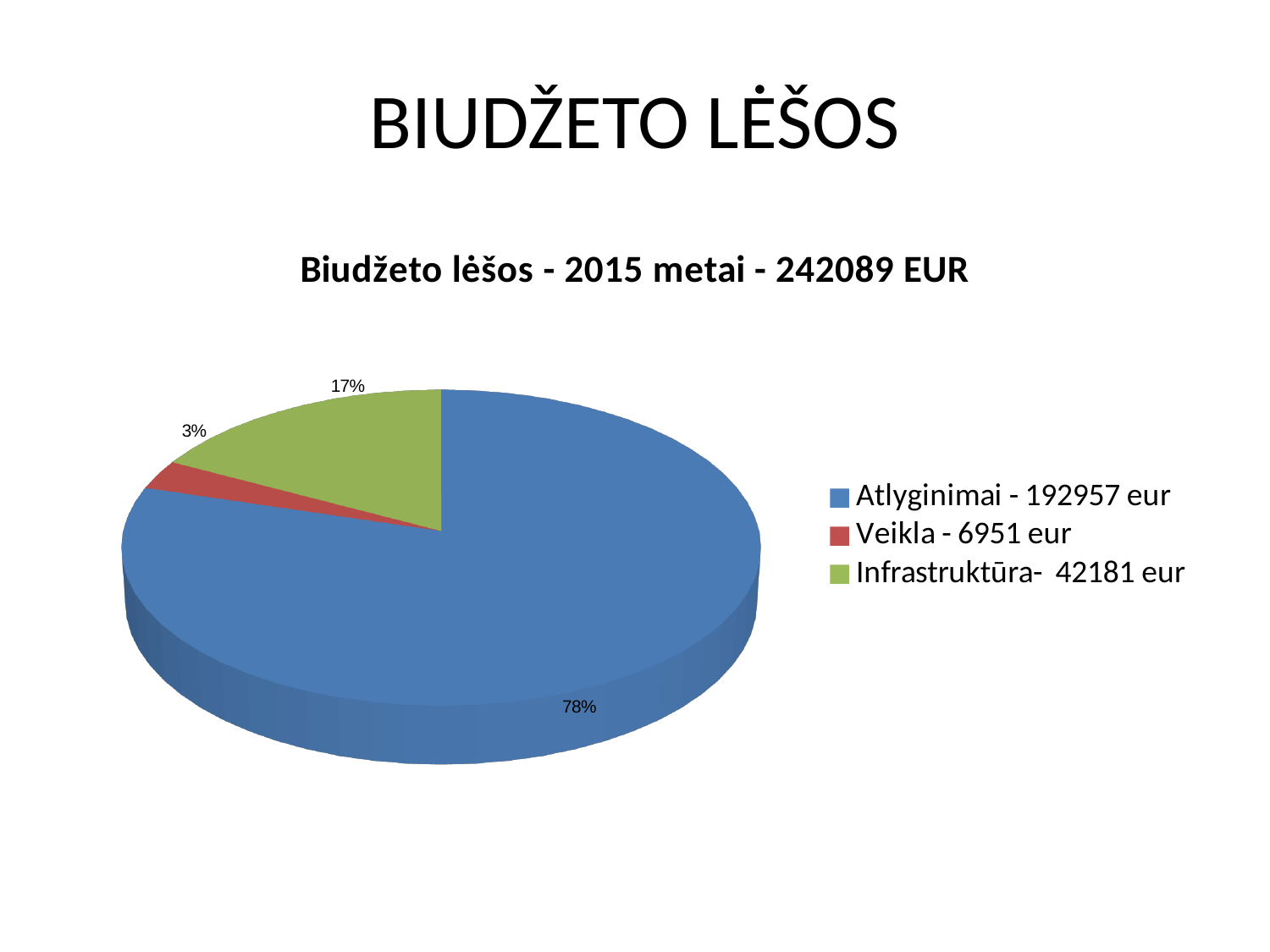
Which category has the largest slice of the pie? Atlyginimai What is the title of the chart? Biudžeto lėšos - 2015 metai - 242089 EUR How many entries does the legend list? 3 What is the difference in percentage points between the Atlyginimai share and the Infrastruktūra share? 61 percentage points How many slices does the pie chart have? 3 What kind of chart is shown on the slide? pie chart Which category has the smallest slice of the pie? Veikla What amount in eur is shown for Infrastruktūra in the legend? 42181 eur What share of the pie does the Veikla slice represent? 3% What share of the pie does the Infrastruktūra slice represent? 17% Which is larger, the Infrastruktūra slice or the Veikla slice? Infrastruktūra What share of the pie does the Atlyginimai slice represent? 78%